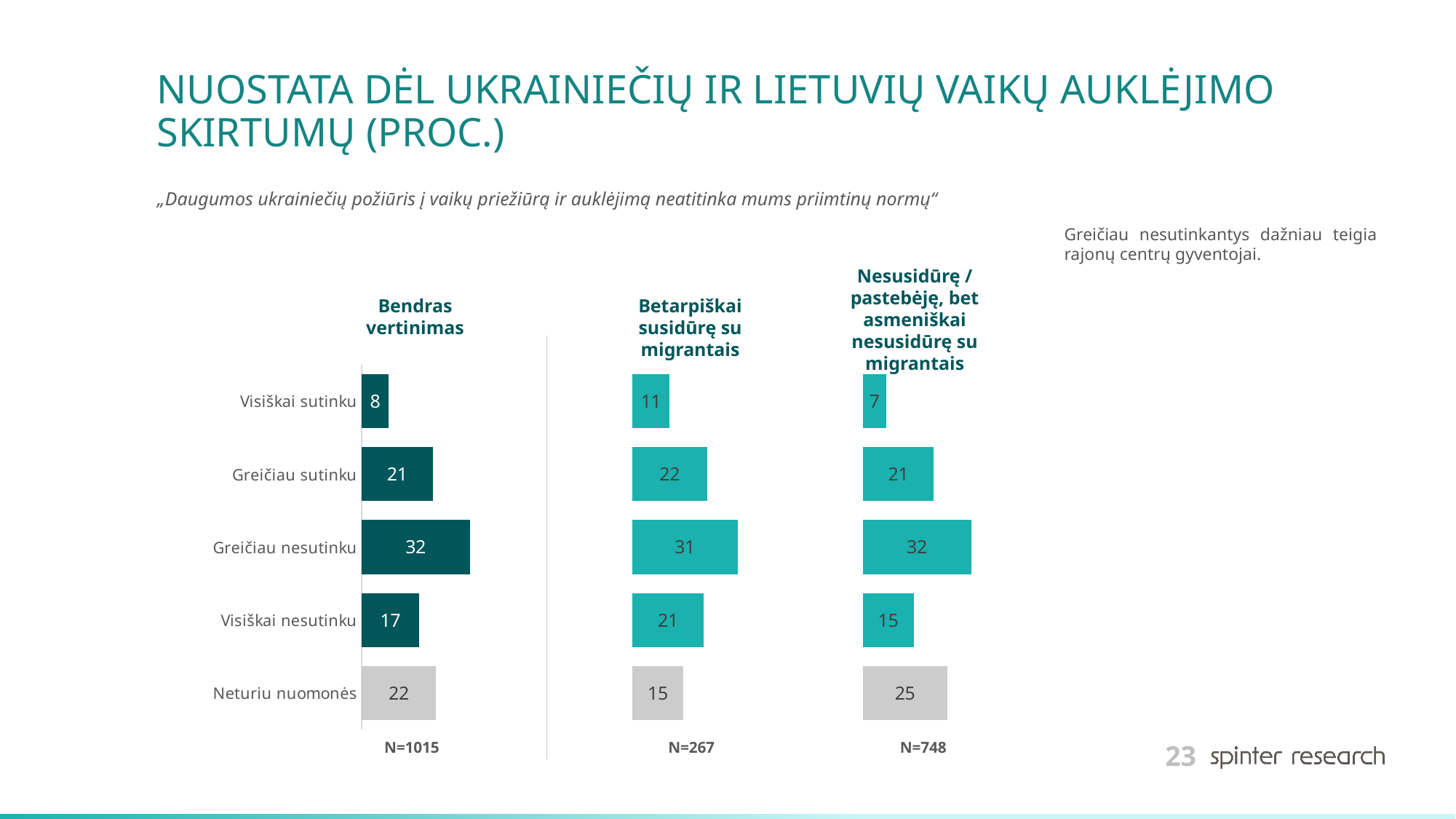
In the "Betarpiškai susidūrę su migrantais" chart, which category has the highest value? Greičiau nesutinku What is the sample size (N) shown under the "Betarpiškai susidūrę su migrantais" chart? N=267 Which is larger: "Neturiu nuomonės" in the "Betarpiškai susidūrę su migrantais" chart or "Neturiu nuomonės" in the "Nesusidūrę / pastebėję, bet asmeniškai nesusidūrę su migrantais" chart? Nesusidūrę / pastebėję, bet asmeniškai nesusidūrę su migrantais In the "Bendras vertinimas" chart, what is the value for "Greičiau nesutinku"? 32 What kind of chart is the "Bendras vertinimas" chart? Bar chart In the "Betarpiškai susidūrę su migrantais" chart, what is the value for "Visiškai nesutinku"? 21 In the "Betarpiškai susidūrę su migrantais" chart, what is the difference between "Greičiau sutinku" and "Visiškai sutinku"? 11 In the "Bendras vertinimas" chart, what is the difference between "Greičiau nesutinku" and "Greičiau sutinku"? 11 In the "Bendras vertinimas" chart, which category has the lowest value? Visiškai sutinku In the "Nesusidūrę / pastebėję, bet asmeniškai nesusidūrę su migrantais" chart, which category has the lowest value? Visiškai sutinku How many categories does the "Bendras vertinimas" chart show? 5 In the "Nesusidūrę / pastebėję, bet asmeniškai nesusidūrę su migrantais" chart, what is the value for "Neturiu nuomonės"? 25